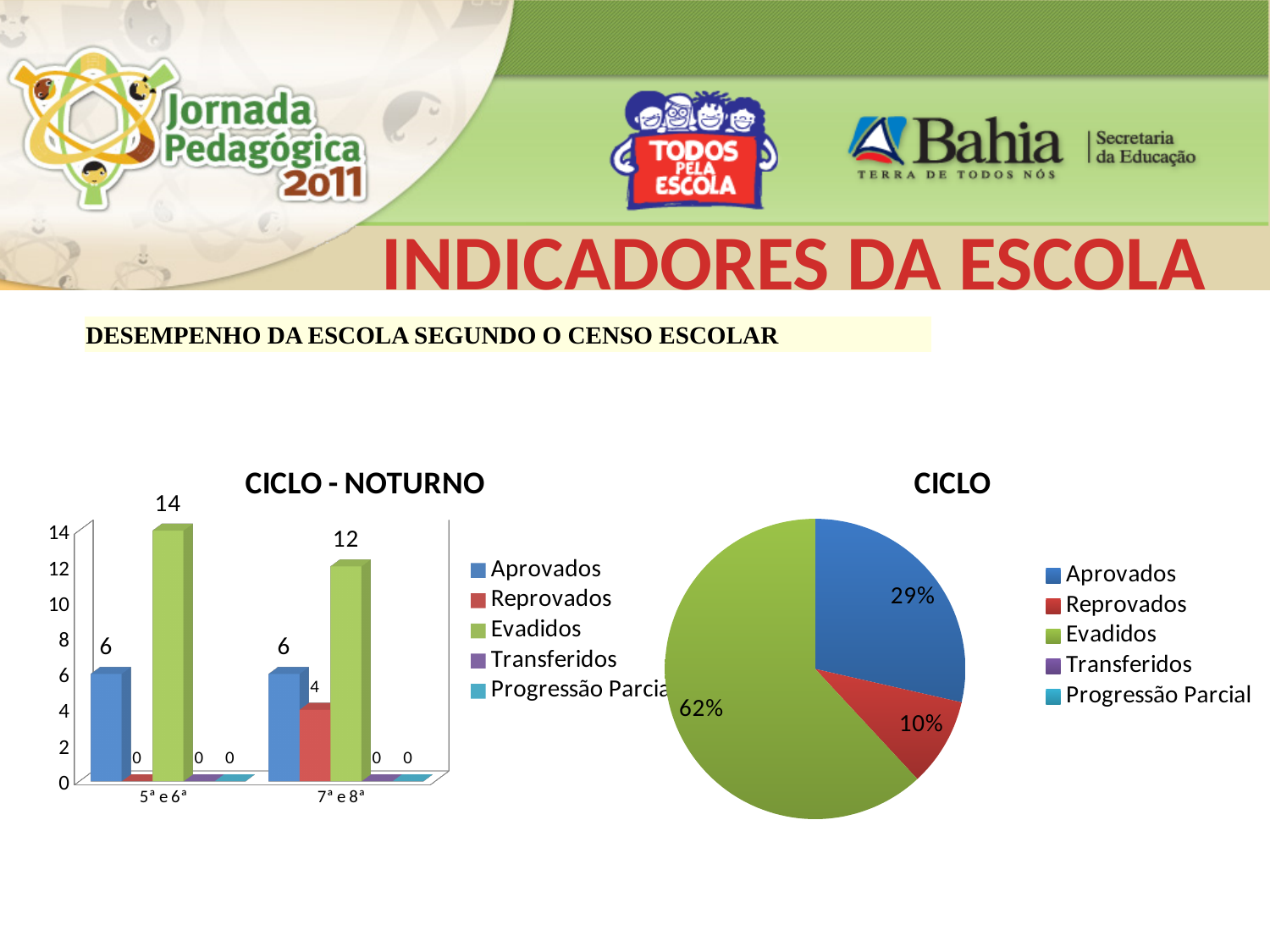
In the CICLO pie chart, which slice is the largest? Evadidos In the CICLO pie chart, what share does Reprovados have? 10% In the CICLO - NOTURNO chart, what is the difference between Evadidos in 5ª e 6ª and Evadidos in 7ª e 8ª? 2 In the CICLO pie chart, what share does Evadidos have? 62% In the CICLO - NOTURNO chart, which series has the highest value in 5ª e 6ª? Evadidos In the CICLO - NOTURNO chart, what is the value for Reprovados in 7ª e 8ª? 4 In the CICLO - NOTURNO chart, how many series does the legend list? 5 In the CICLO - NOTURNO chart, what is the value for Aprovados in 7ª e 8ª? 6 In the CICLO - NOTURNO chart, how many categories are shown on the x axis? 2 What kind of chart is CICLO - NOTURNO? bar chart In the CICLO - NOTURNO chart, what is the value for Evadidos in 5ª e 6ª? 14 In the CICLO - NOTURNO chart, which is larger: Aprovados or Reprovados in 7ª e 8ª? Aprovados